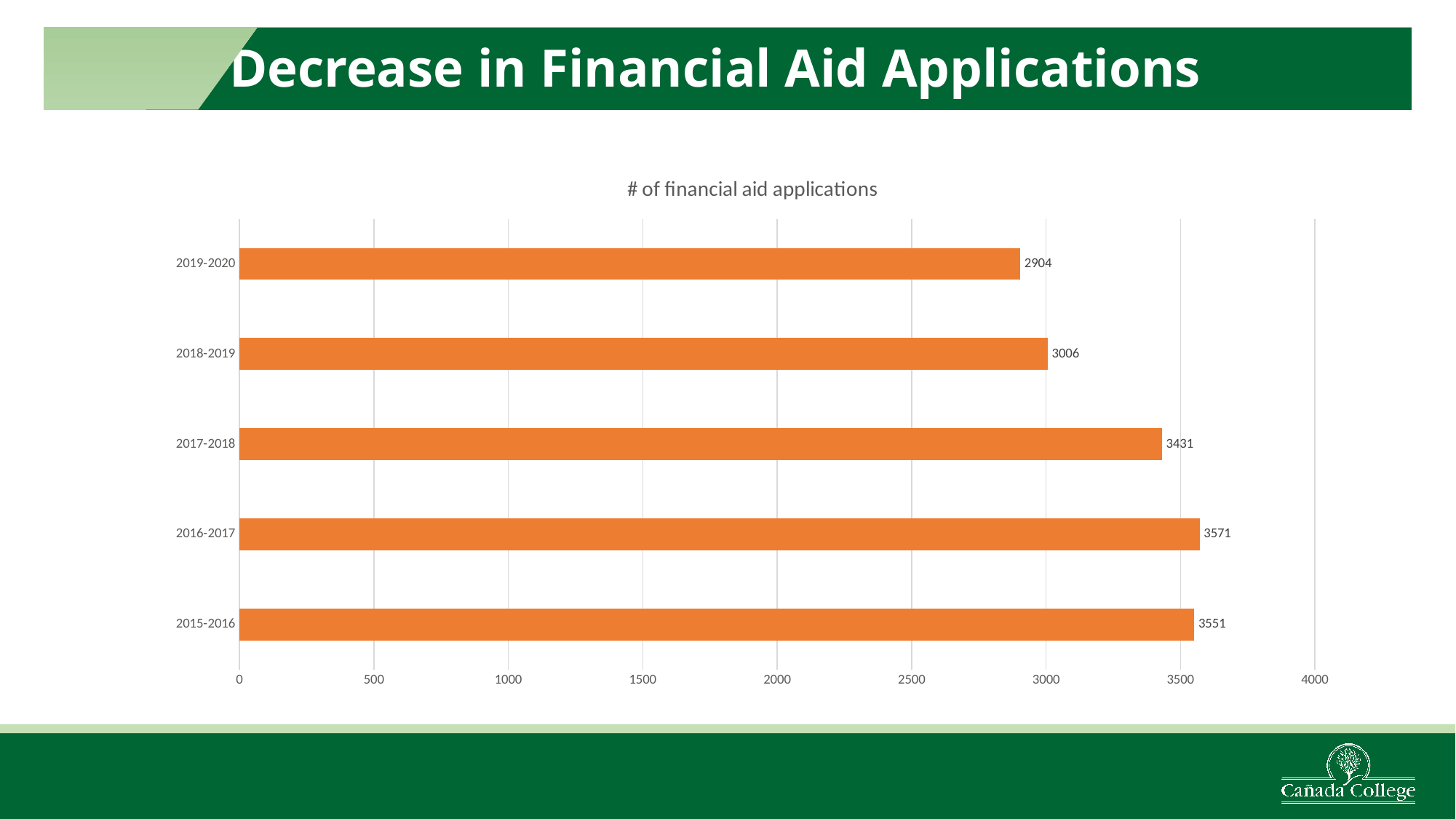
Which year had more financial aid applications, 2017-2018 or 2018-2019? 2017-2018 Which year has the lowest number of financial aid applications? 2019-2020 What is the difference in financial aid applications between 2016-2017 and 2017-2018? 140 Is the value for 2019-2020 greater or less than 3000? less What is the difference in financial aid applications between 2018-2019 and 2019-2020? 102 What is the number of financial aid applications for 2017-2018? 3431 What type of chart is shown on the slide? bar chart What is the number of financial aid applications for 2015-2016? 3551 What is the number of financial aid applications for 2019-2020? 2904 Which year has the highest number of financial aid applications? 2016-2017 How many academic years are shown in the chart? 5 What is the title of the chart? # of financial aid applications